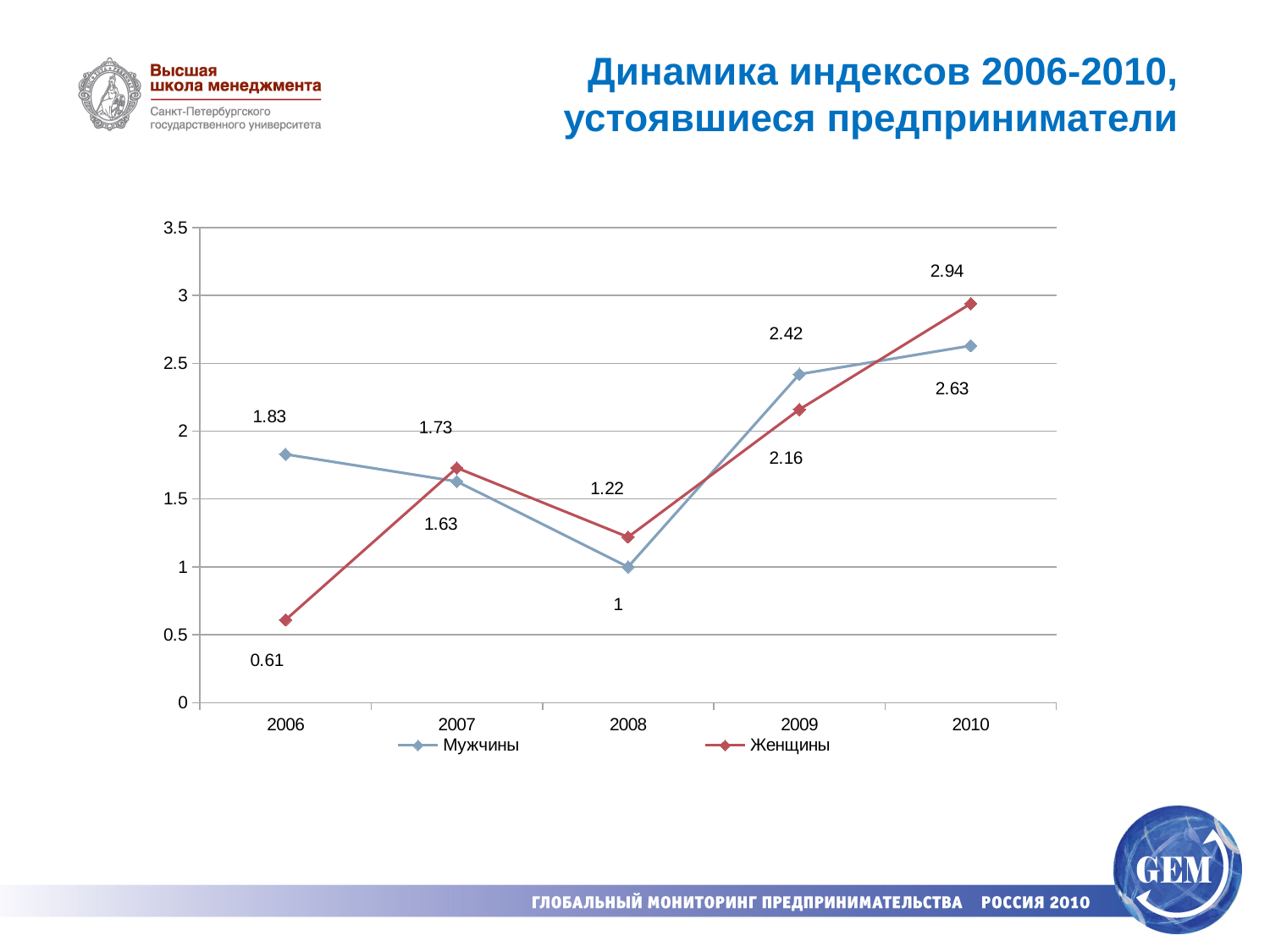
What is the value for Мужчины in 2006? 1.83 How many series does the legend list? 2 In which year is the value for Мужчины highest? 2010 What is the value for Мужчины in 2008? 1 In which year is the value for Женщины lowest? 2006 How many years are plotted on the x axis? 5 Which series has the larger value in 2009, Мужчины or Женщины? Мужчины What type of chart is shown on the slide? line chart Does the value for Женщины rise or fall from 2008 to 2010? rise What is the value for Женщины in 2006? 0.61 What is the difference between the Женщины and Мужчины values in 2010? 0.31 What is the value for Женщины in 2010? 2.94